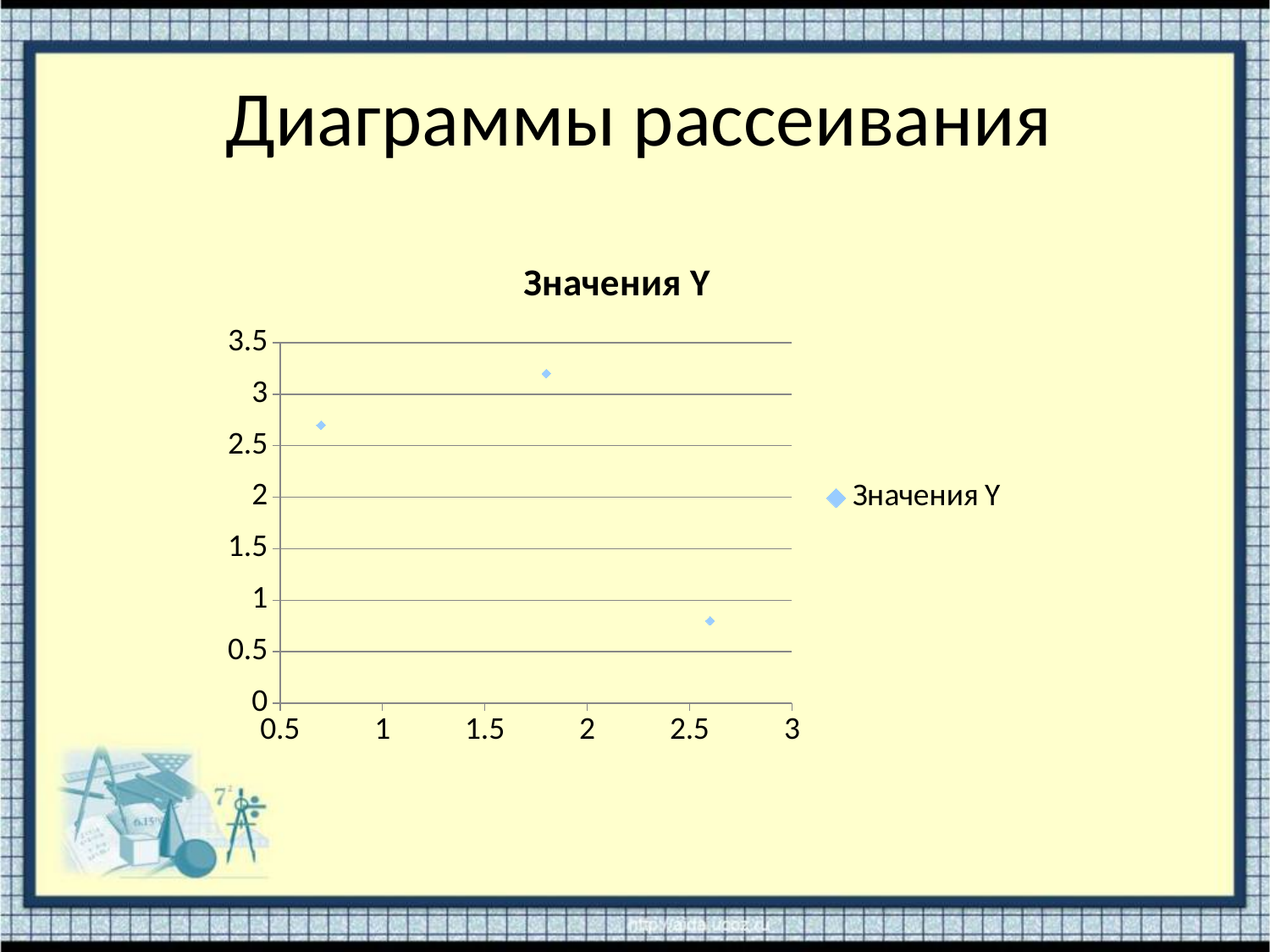
How many data points are plotted on the chart? 3 Is the y value of the leftmost point (near x = 0.7) greater or less than 2.5? greater What is the name of the series shown in the legend? Значения Y Which point has the highest y value: the leftmost, the middle, or the rightmost? the middle Is the y value of the middle point (near x = 1.8) greater or less than 3? greater Which point has the lowest y value: the leftmost, the middle, or the rightmost? the rightmost Which has the larger y value, the leftmost point or the rightmost point? the leftmost point How many series does the legend list? 1 What kind of chart is shown on the slide? scatter chart What is the title of the chart? Значения Y Is the y value of the rightmost point (near x = 2.6) greater or less than 1? less Do the y values rise or fall from the middle point to the rightmost point? fall